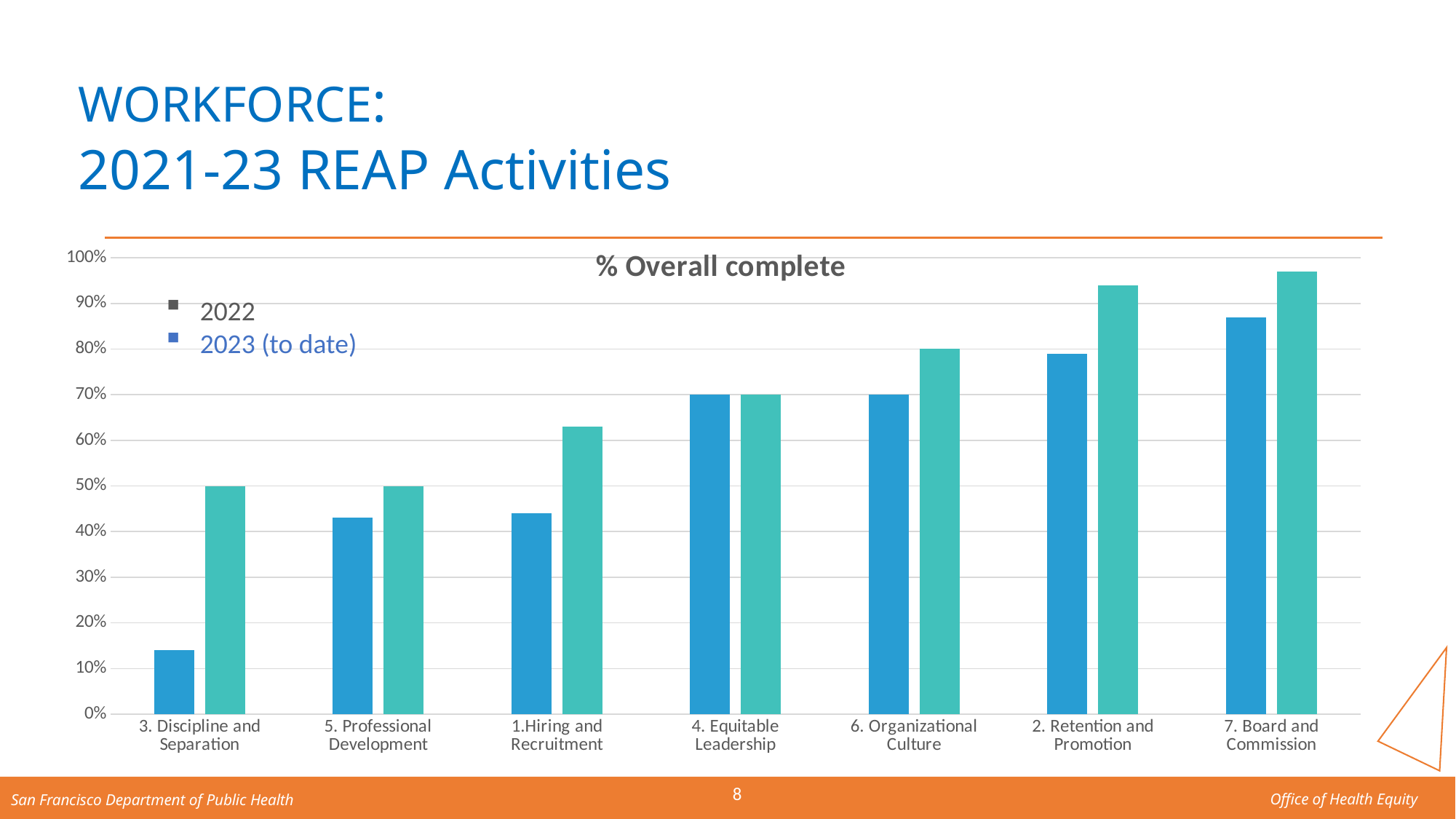
What is the 2023 (to date) value for 3. Discipline and Separation? 50% Is the 2023 (to date) value for 2. Retention and Promotion greater or less than 90%? greater What is the 2022 value for 4. Equitable Leadership? 70% Which category has the highest 2023 (to date) value? 7. Board and Commission Is the 2022 value for 3. Discipline and Separation greater or less than 20%? less What kind of chart is shown on the slide? bar chart How many series does the legend list? 2 Which is larger for 1.Hiring and Recruitment, the 2022 value or the 2023 (to date) value? 2023 (to date) How many categories are shown on the x axis? 7 What is the 2023 (to date) value for 6. Organizational Culture? 80% What is the title of the chart? % Overall complete Which category has the lowest 2022 value? 3. Discipline and Separation